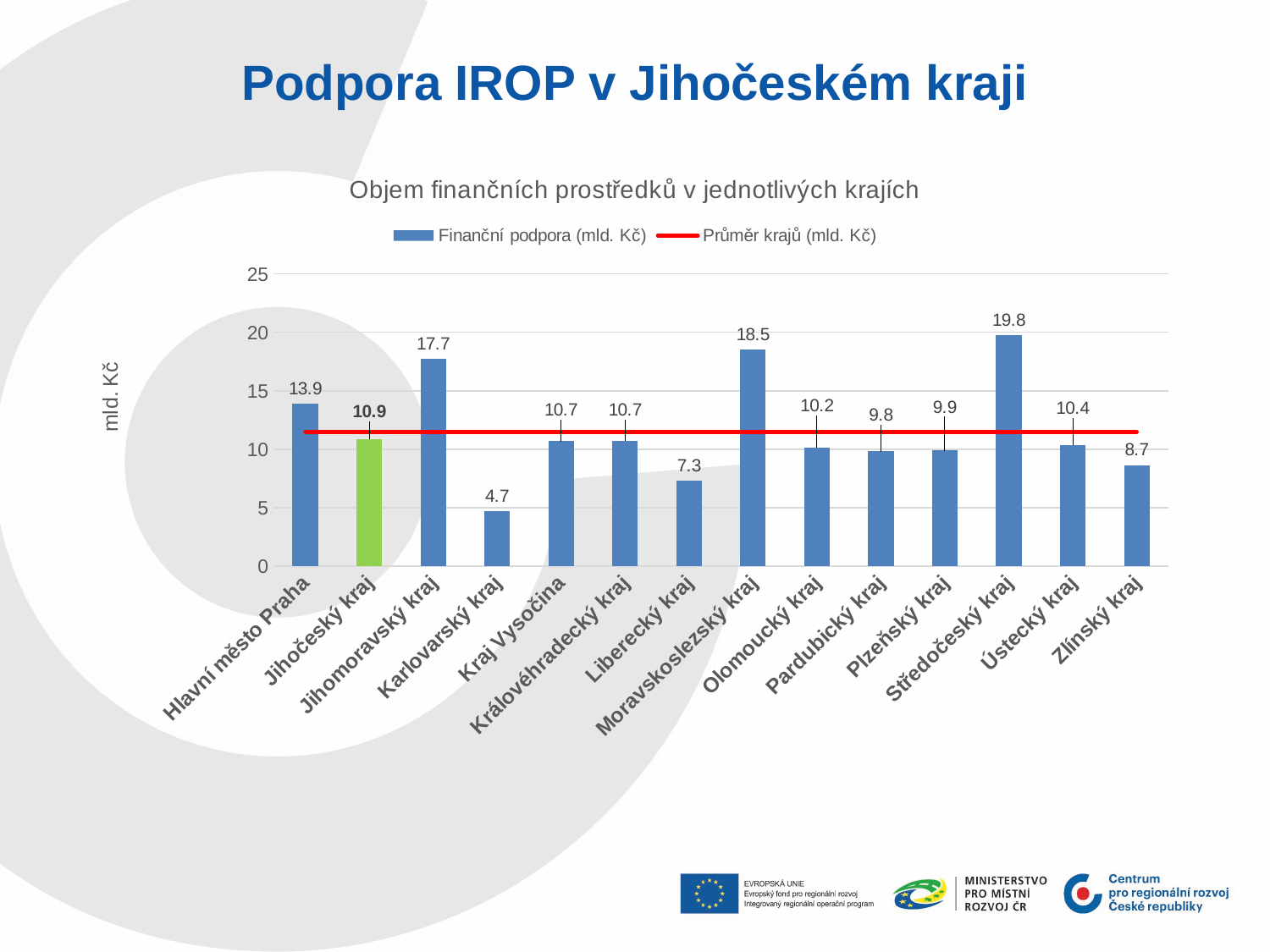
Is the value for Moravskoslezský kraj greater or less than 15? greater What is the difference between the values for Středočeský kraj and Karlovarský kraj? 15.1 How many regions are shown on the x axis? 14 Which region has the highest financial support? Středočeský kraj What kind of chart is this? combination bar and line chart What is the title of the chart? Objem finančních prostředků v jednotlivých krajích Which region has the lowest financial support? Karlovarský kraj What is the value for Středočeský kraj? 19.8 How many series does the legend list? 2 Which is larger, the value for Hlavní město Praha or the value for Jihočeský kraj? Hlavní město Praha What is the value for Karlovarský kraj? 4.7 What is the value for Jihočeský kraj? 10.9